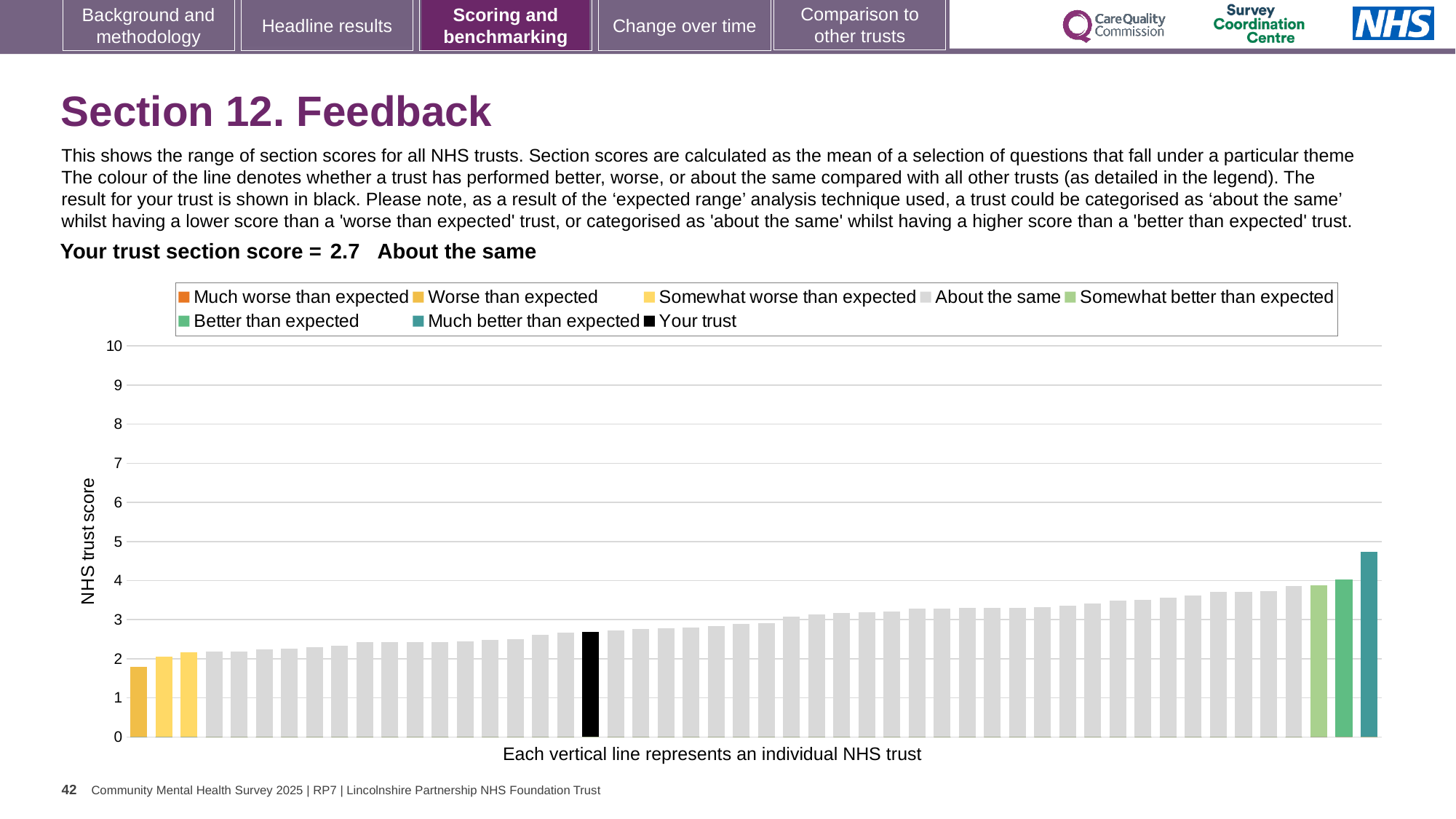
Do the bar values rise or fall from left to right along the x axis? rise Is the value for your trust (the black bar) greater or less than 3? less What colour is the bar representing your trust? black What is the section score for your trust shown on the slide? 2.7 Is the value of the tallest bar greater or less than 4? greater What kind of chart is shown on the slide? bar chart How many categories does the chart legend list? 8 Which legend category does the tallest bar belong to? Much better than expected Which legend category does the shortest bar belong to? Worse than expected Is the value of the shortest bar greater or less than 2? less What is the label on the y axis of the chart? NHS trust score How many bars are coloured as 'Somewhat worse than expected'? 2